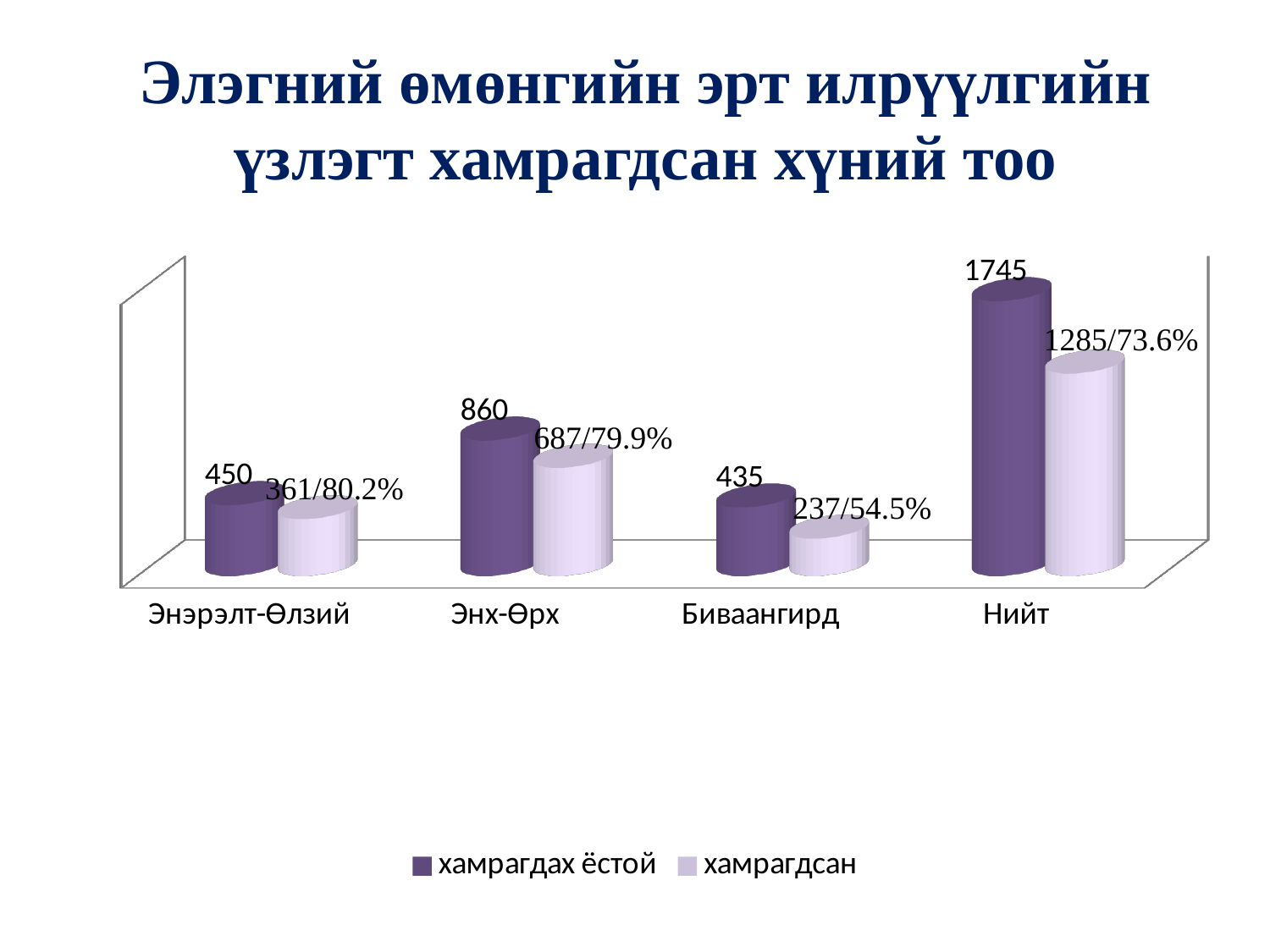
What is the value for Нийт in the хамрагдах ёстой series? 1745 How many series does the legend list? 2 What is the difference between the хамрагдах ёстой value and the хамрагдсан count for Биваангирд? 198 What is the value for Энх-Өрх in the хамрагдах ёстой series? 860 What is the difference between the хамрагдах ёстой value and the хамрагдсан count for Нийт? 460 What data label is shown for Биваангирд in the хамрагдсан series? 237/54.5% What data label is shown for Энэрэлт-Өлзий in the хамрагдсан series? 361/80.2% What kind of chart is shown on the slide? Bar chart Which category has the highest value in the хамрагдах ёстой series? Нийт Which category has the lowest value in the хамрагдсан series? Биваангирд Which is larger: the хамрагдах ёстой value for Энэрэлт-Өлзий or for Биваангирд? Энэрэлт-Өлзий How many categories are shown on the x axis? 4